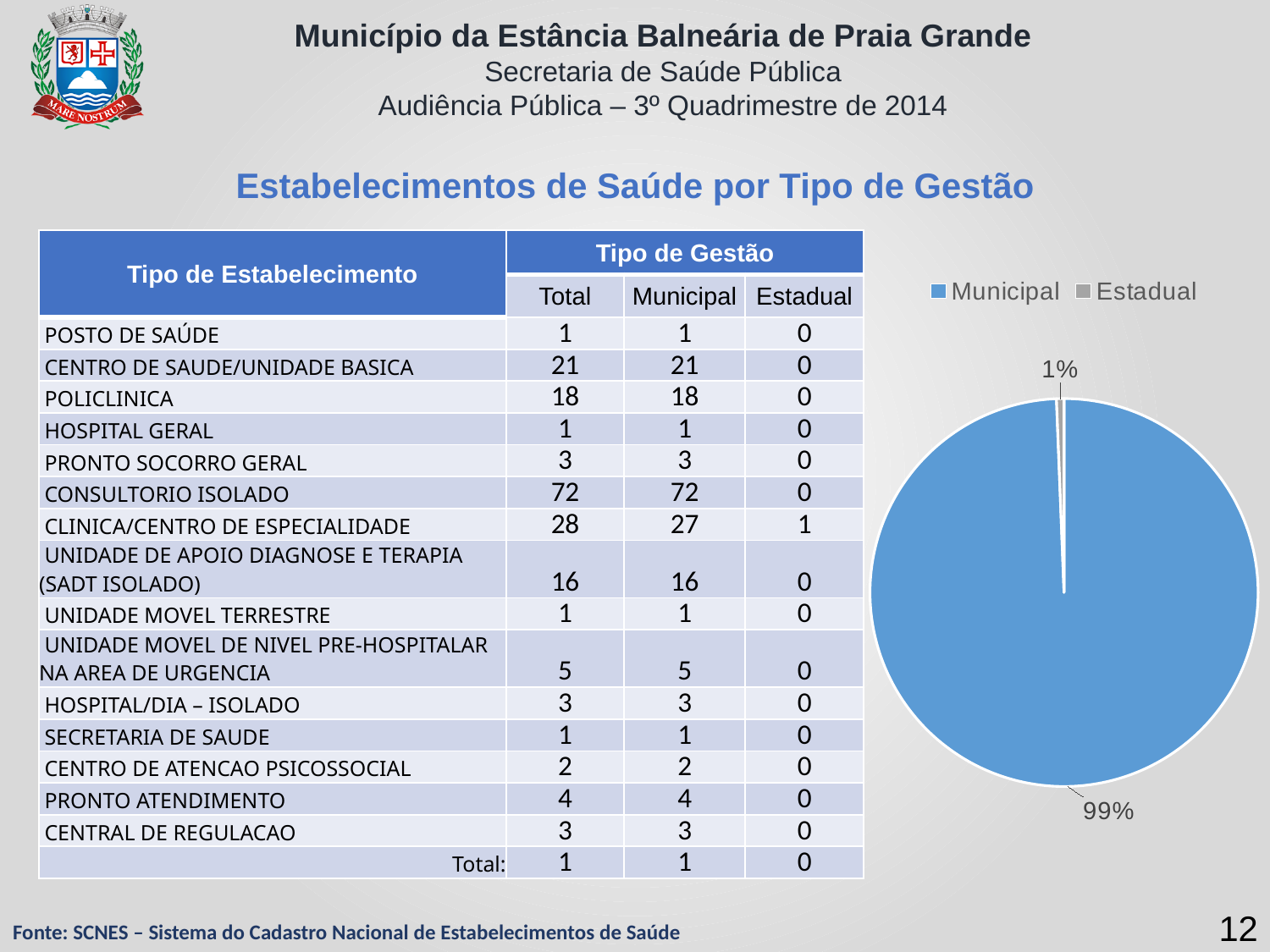
How many entries does the pie chart's legend list? 2 What are the two entries in the pie chart's legend? Municipal and Estadual Which is larger in the pie chart, Municipal or Estadual? Municipal What share of the pie chart does Estadual represent? 1% What share of the pie chart does Municipal represent? 99% What kind of chart is shown on the slide? pie chart How many slices does the pie chart have? 2 What colour is the Municipal slice of the pie chart? blue What is the difference in percentage points between the Municipal and Estadual slices of the pie chart? 98 Which slice of the pie chart is the largest? Municipal Which slice of the pie chart is the smallest? Estadual